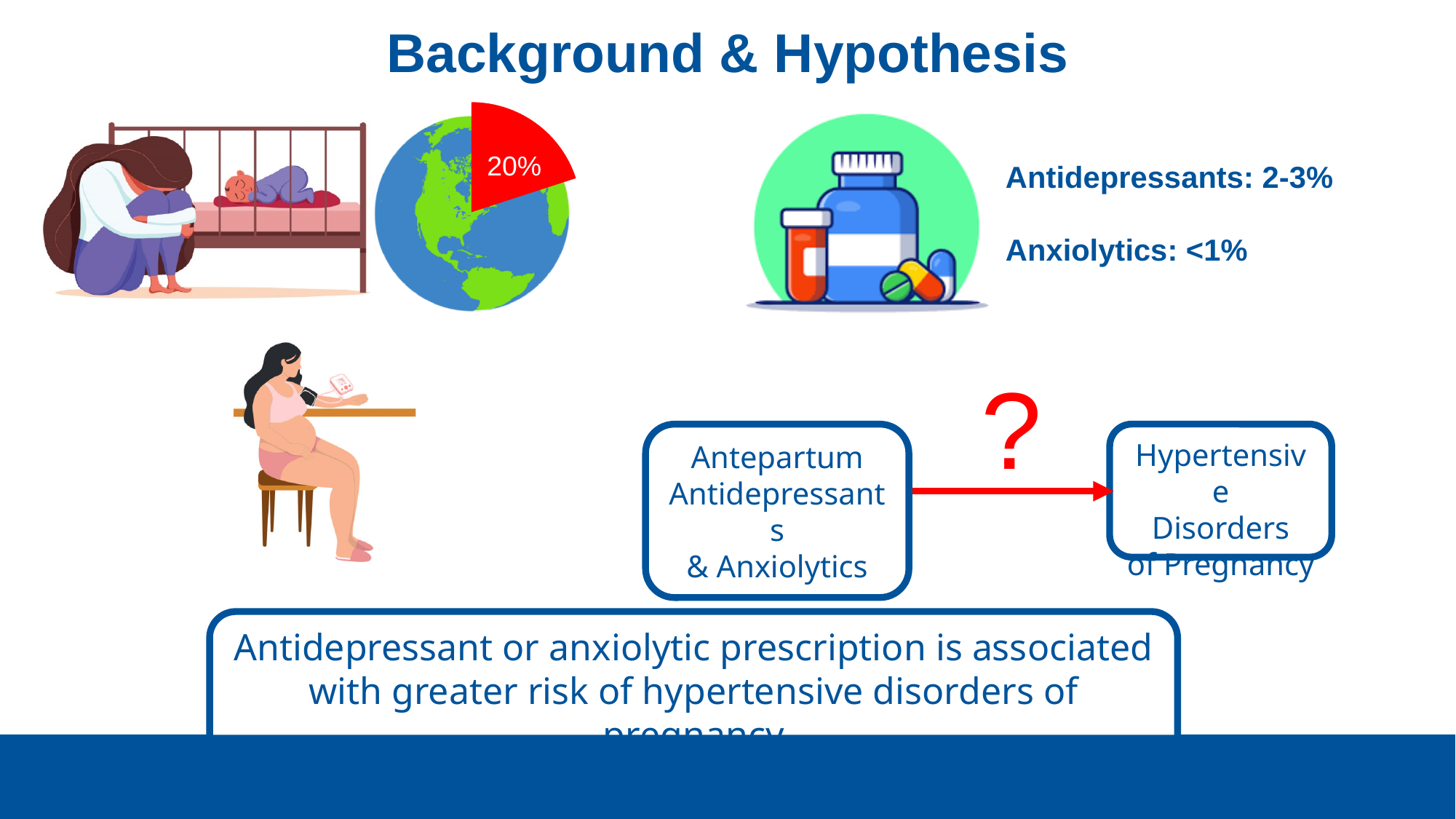
How many slices of the pie chart on the globe carry a data label? 1 What colour is the labelled slice of the pie chart on the globe? red What value is printed on the red slice of the pie chart over the globe? 20% What share of the pie chart does the red slice represent? 20% What kind of chart is overlaid on the globe image? pie chart